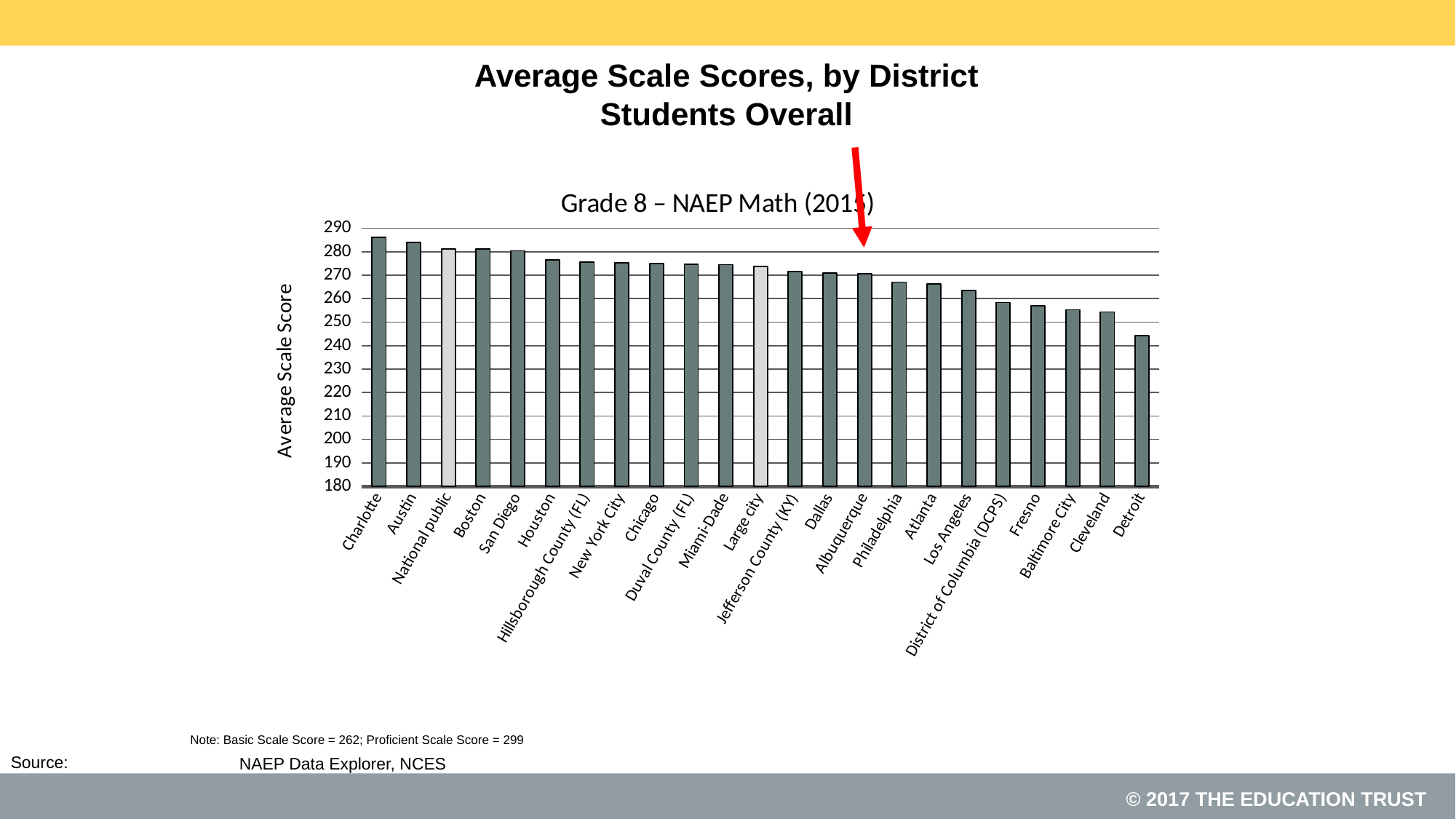
Is the value for Cleveland greater or less than 260? less Which district has the lowest average scale score? Detroit What is the label on the vertical axis of the chart? Average Scale Score Is the value for Houston greater or less than 270? greater How many districts or groups are plotted on the chart? 23 Is the value for Charlotte greater or less than 280? greater Which district has the highest average scale score? Charlotte Which has a higher average scale score, Baltimore City or Houston? Houston Which has a higher average scale score, Austin or Los Angeles? Austin What kind of chart is shown on the slide? bar chart Do the values rise or fall moving from left to right along the x axis? fall